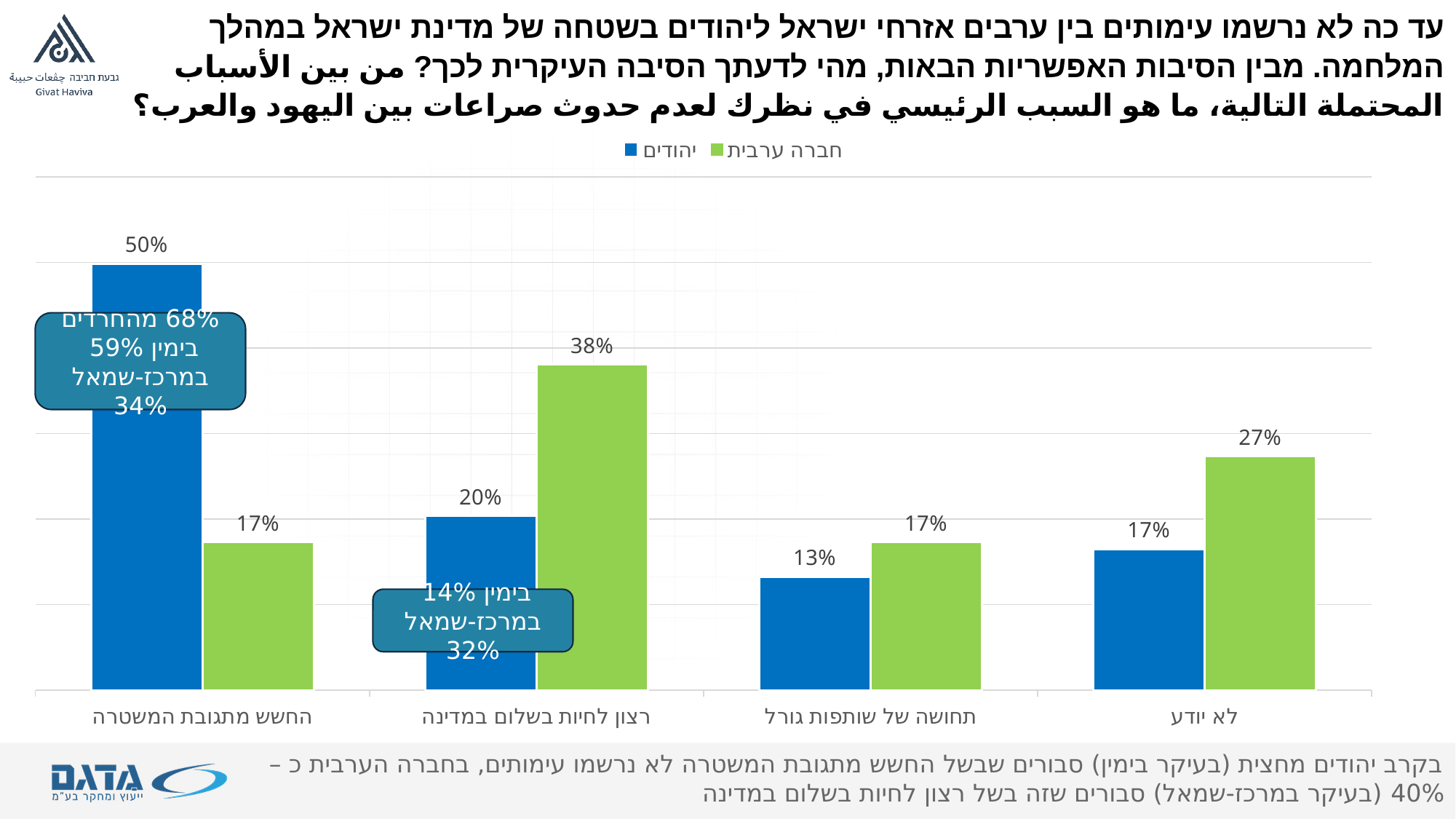
What is the value for חברה ערבית in the category לא יודע? 27% What is the value for יהודים in the category חשש מתגובת המשטרה? 50% How many categories are shown on the x axis? 4 What is the value for חברה ערבית in the category רצון לחיות בשלום במדינה? 38% Which category has the highest value for חברה ערבית? רצון לחיות בשלום במדינה In the category רצון לחיות בשלום במדינה, which series has the larger value, יהודים or חברה ערבית? חברה ערבית What kind of chart is shown on the slide? Bar chart What is the difference between the יהודים and חברה ערבית values in the category חשש מתגובת המשטרה? 33% Which category has the highest value for יהודים? החשש מתגובת המשטרה How many series does the legend list? 2 What is the value for יהודים in the category תחושה של שותפות גורל? 13% Which category has the lowest value for יהודים? תחושה של שותפות גורל